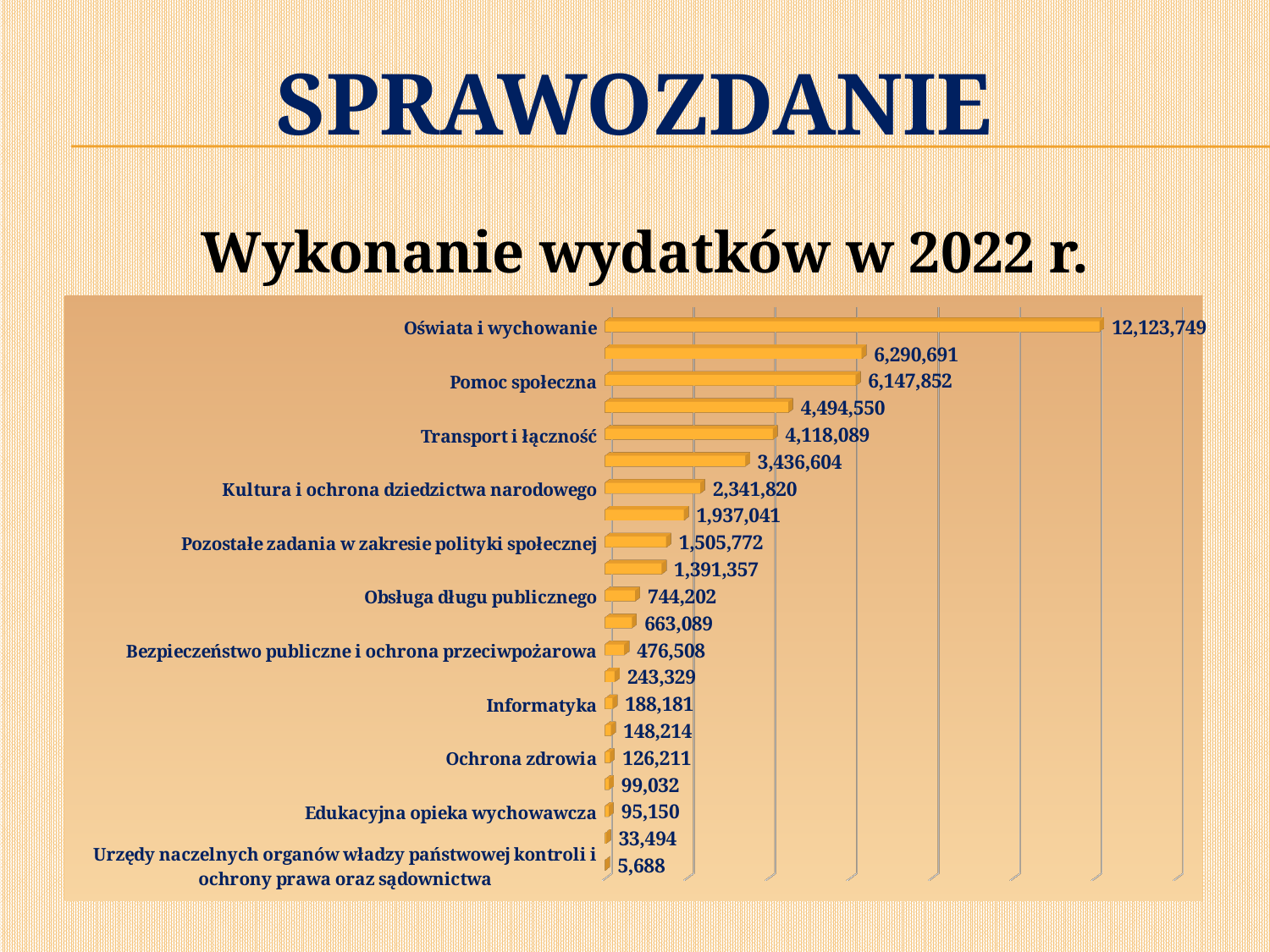
How many bars are plotted in the chart? 21 What is the value for Transport i łączność? 4,118,089 Which category has the lowest value? Urzędy naczelnych organów władzy państwowej kontroli i ochrony prawa oraz sądownictwa What is the value for Informatyka? 188,181 What is the value for Oświata i wychowanie? 12,123,749 What is the value for Obsługa długu publicznego? 744,202 What is the difference between the values for Oświata i wychowanie and Pomoc społeczna? 5,975,897 What type of chart is shown on the slide? bar chart What is the title of the chart? Wykonanie wydatków w 2022 r. What is the value for Pomoc społeczna? 6,147,852 Which is larger, the value for Kultura i ochrona dziedzictwa narodowego or the value for Transport i łączność? Transport i łączność Which category has the highest value? Oświata i wychowanie